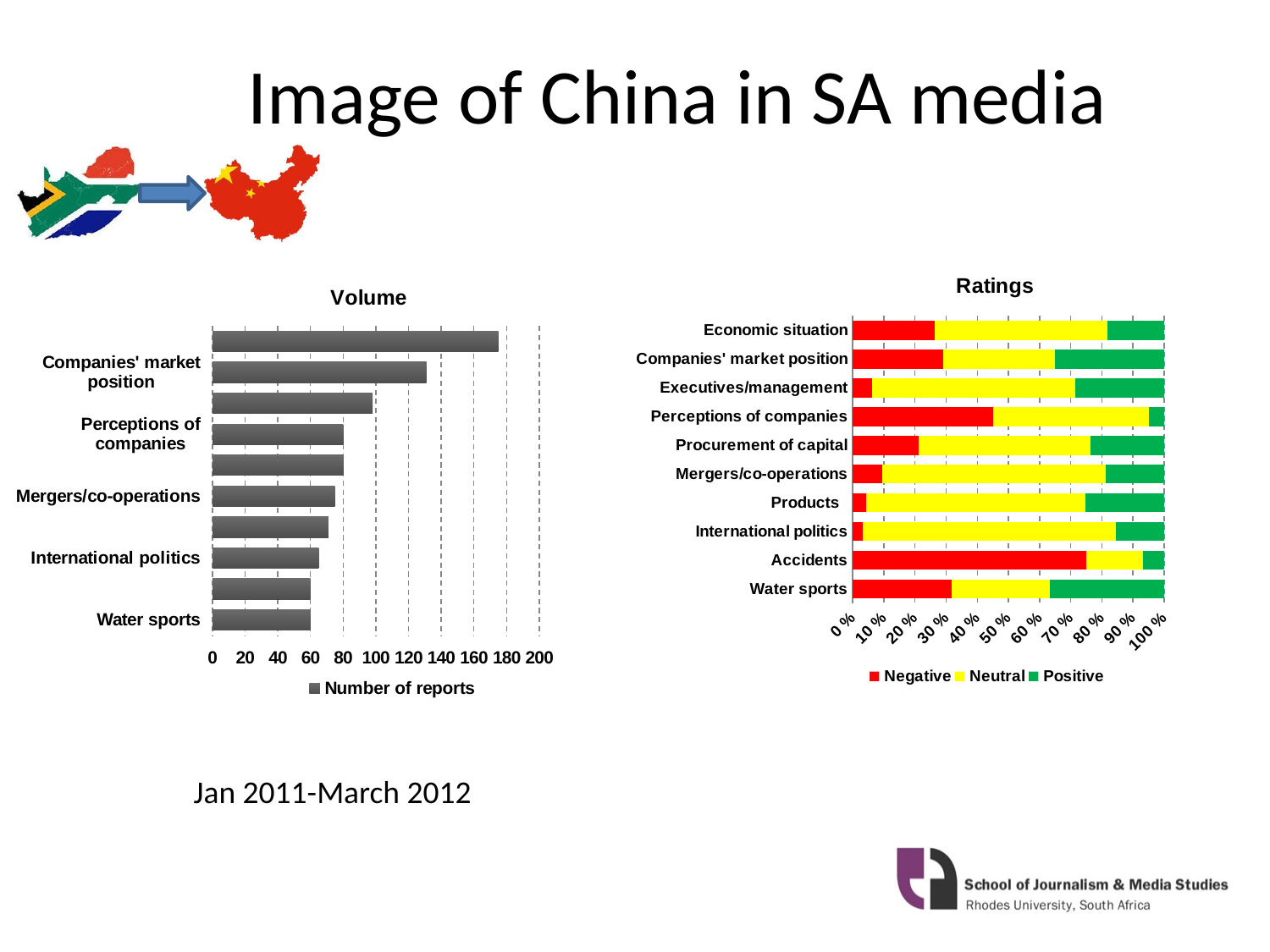
In the Volume chart, how many bars are plotted? 10 What kind of chart is the Ratings chart? stacked bar chart In the Ratings chart, is the Negative share for Accidents greater or less than 70 %? greater In the Ratings chart, which series is shown in red? Negative In the Volume chart, is the value for International politics greater or less than 80? less In the Volume chart, which has more reports: Companies' market position or Water sports? Companies' market position In the Volume chart, is the value for Water sports greater or less than 80? less In the Ratings chart, how many series does the legend list? 3 In the Ratings chart, which category has the largest Negative share? Accidents What kind of chart is the Volume chart? bar chart In the Ratings chart, how many categories are shown on the vertical axis? 10